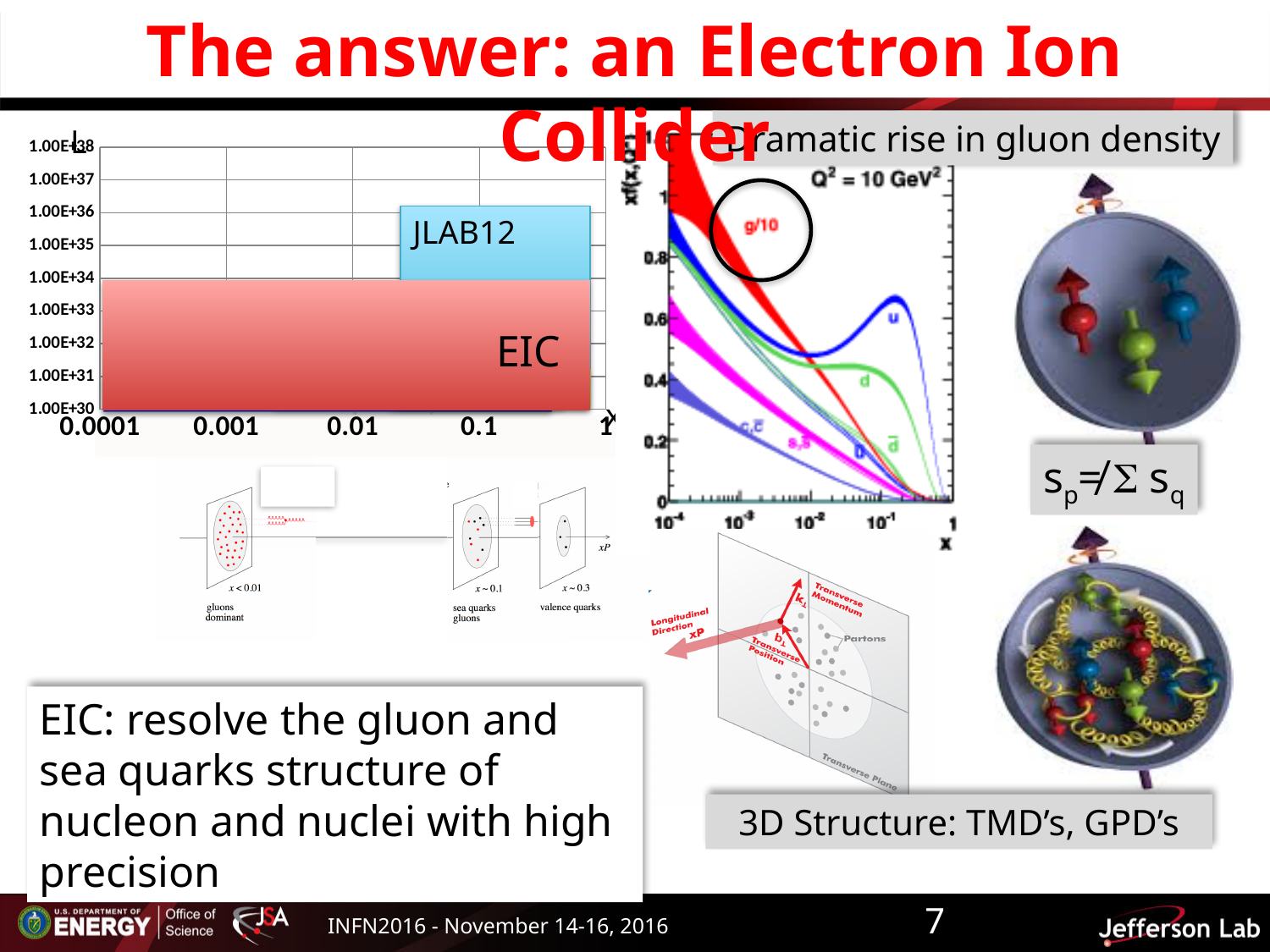
On the luminosity chart on the left, what is the largest x value shown on the horizontal axis? 1 On the luminosity chart on the left, how many labeled regions are plotted? 2 On the luminosity chart on the left, what colour is the EIC region? red On the luminosity chart on the left, what is the upper luminosity edge of the JLAB12 region? 1.00E+36 On the luminosity chart on the left, what is the highest luminosity tick shown on the vertical axis? 1.00E+38 On the luminosity chart on the left, what is the smallest x value shown on the horizontal axis? 0.0001 On the luminosity chart on the left, which labeled region reaches the higher luminosity, JLAB12 or EIC? JLAB12 On the parton distribution chart in the middle of the slide, what Q² value is stated? Q² = 10 GeV² On the luminosity chart on the left, at what luminosity value do the EIC and JLAB12 regions meet? 1.00E+34 On the luminosity chart on the left, is the lowest x value covered by the JLAB12 region greater or less than 0.01? greater On the luminosity chart on the left, what is the lower luminosity edge of the EIC region? 1.00E+30 On the luminosity chart on the left, which labeled region extends to the lowest x value? EIC